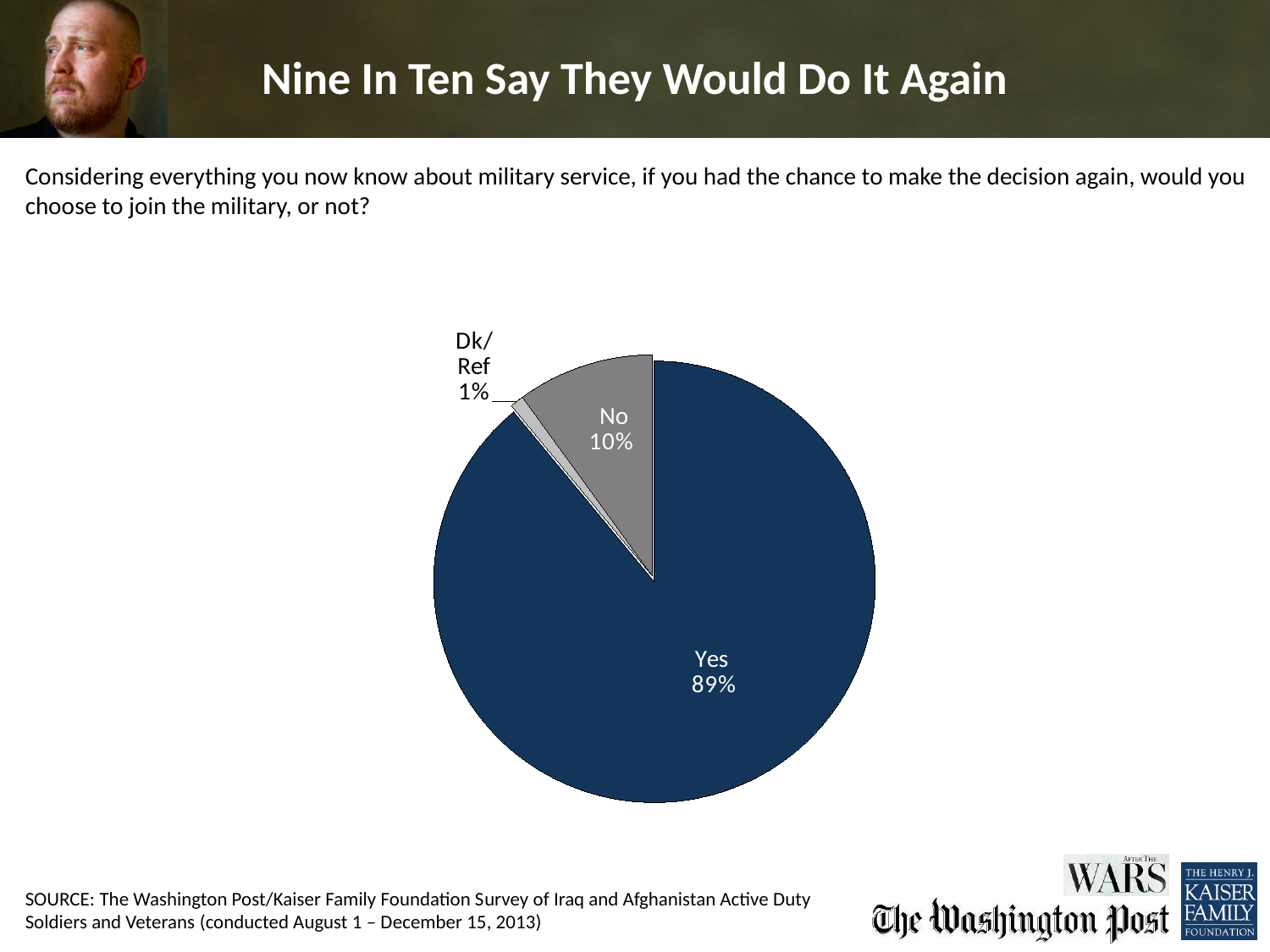
What kind of chart is shown on the slide? pie chart Which is larger, the share for No or the share for Dk/Ref? No How many slices does the pie chart have? 3 What percentage of respondents said No? 10% What colour is the Yes slice? dark blue Which response has the smallest share of the pie? Dk/Ref Which response has the largest share of the pie? Yes What is the title of the slide? Nine In Ten Say They Would Do It Again What share of the pie does the Yes slice represent? 89% What percentage of respondents answered Dk/Ref? 1% What percentage of respondents said Yes? 89% What is the difference in percentage points between Yes and No? 79